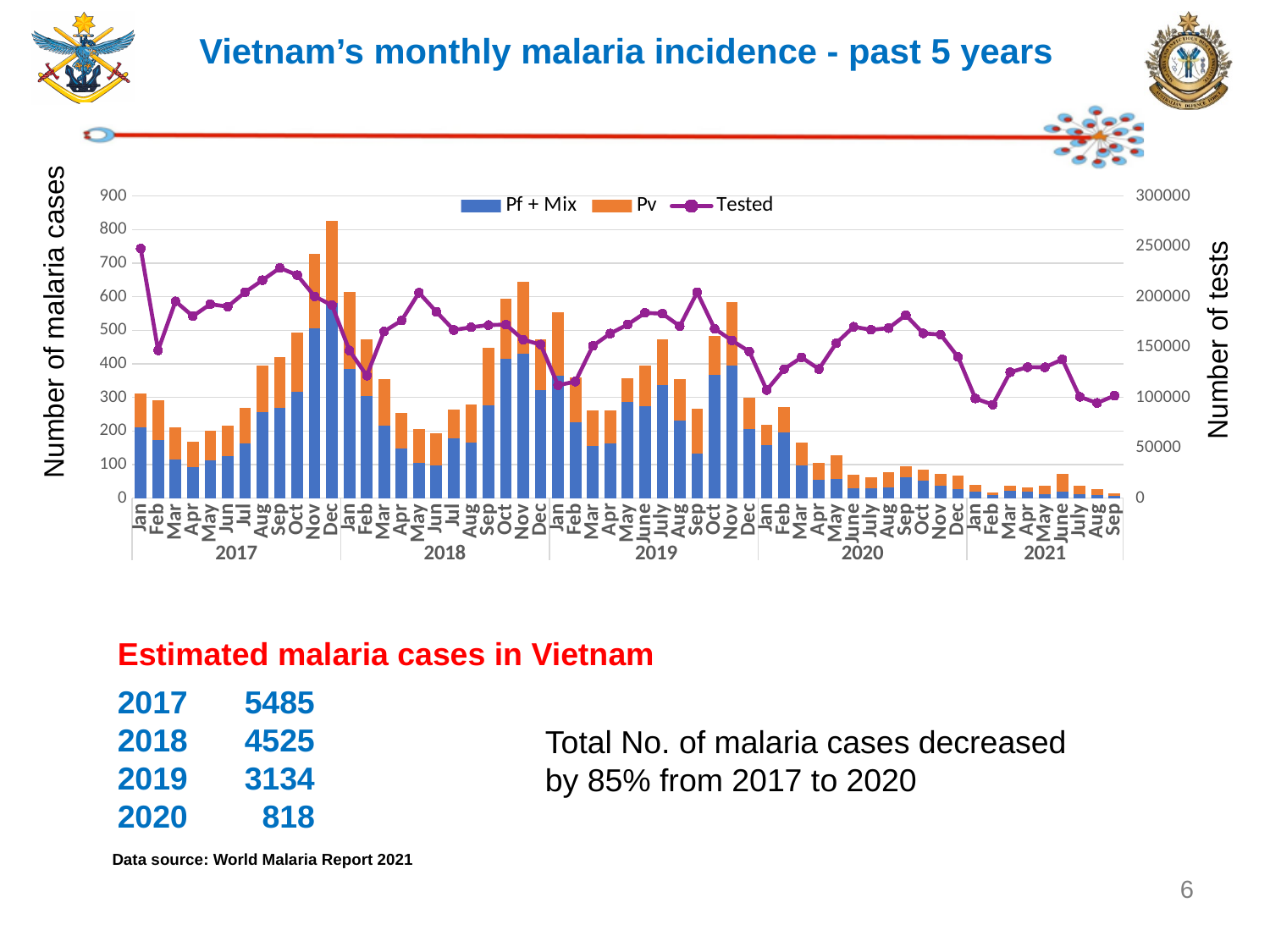
Which has the larger total stacked bar of malaria cases, Dec 2017 or Dec 2018? Dec 2017 What kind of chart is shown on the slide? A combined bar and line chart (stacked bars with a line) What are the three series named in the legend? Pf + Mix, Pv, Tested Is the Tested value for Feb 2018 greater or less than 150000? less Is the total number of malaria cases for Sep 2021 greater or less than 100? less Is the Tested value for Jan 2017 greater or less than 200000? greater In which month and year does the Tested line reach its highest value? Jan 2017 What is the label on the left vertical axis of the chart? Number of malaria cases How many series does the chart legend list? 3 Overall, do the monthly malaria case bars rise or fall from 2017 to 2021? fall In which month and year is the total stacked bar of malaria cases highest? Dec 2017